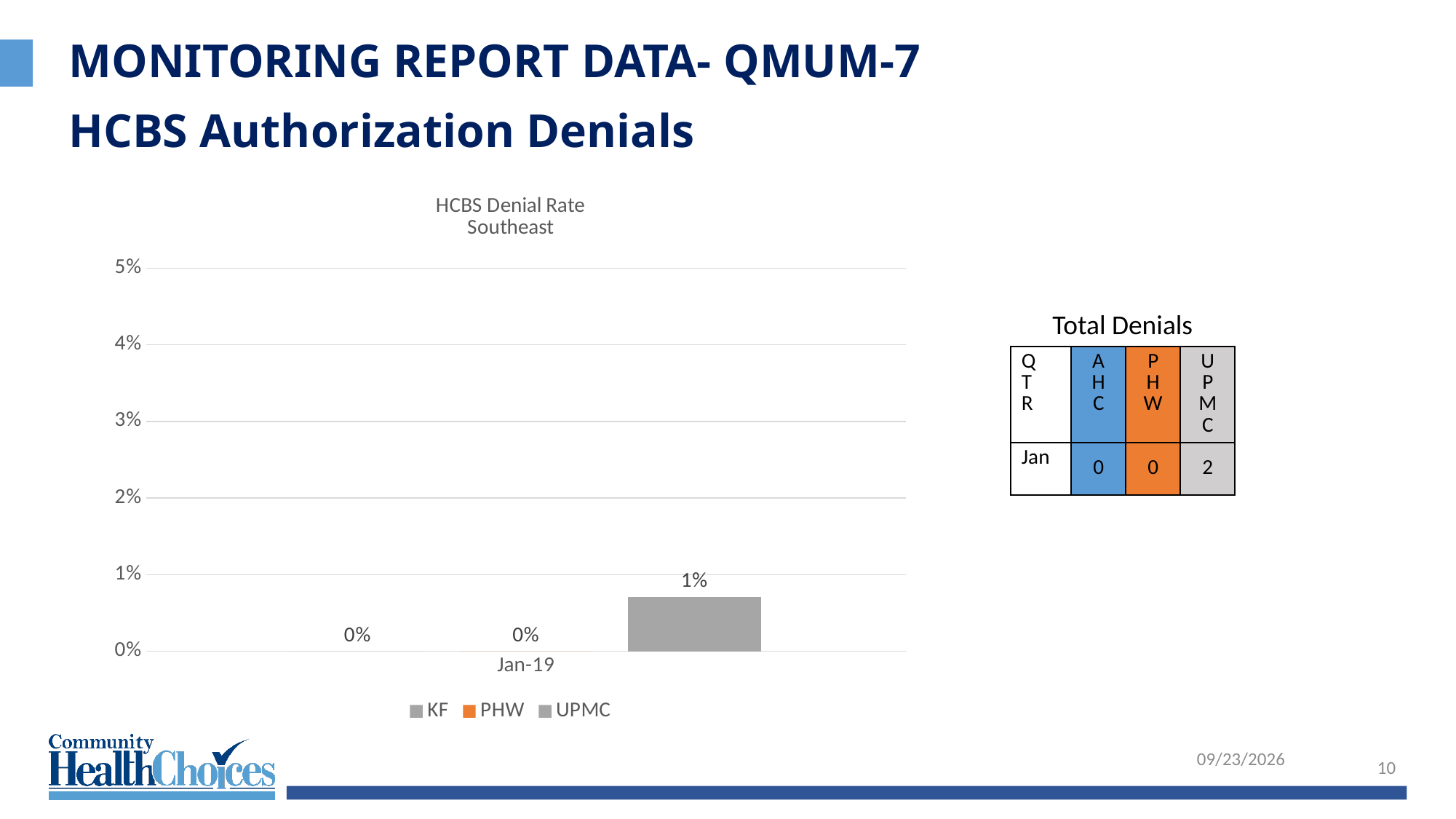
What is the HCBS denial rate for PHW in Jan-19? 0% Which series has the highest HCBS denial rate in Jan-19? UPMC What is the difference between the UPMC and KF denial rates in Jan-19? 1% How many categories are shown on the x axis of the chart? 1 Is the UPMC denial rate for Jan-19 greater or less than 2%? less What is the HCBS denial rate for KF in Jan-19? 0% What is the highest value shown on the chart's y axis? 5% Which is larger in Jan-19, the denial rate for UPMC or for PHW? UPMC How many series does the chart legend list? 3 What is the HCBS denial rate for UPMC in Jan-19? 1% What kind of chart is shown on the slide? bar chart What is the title of the chart? HCBS Denial Rate Southeast